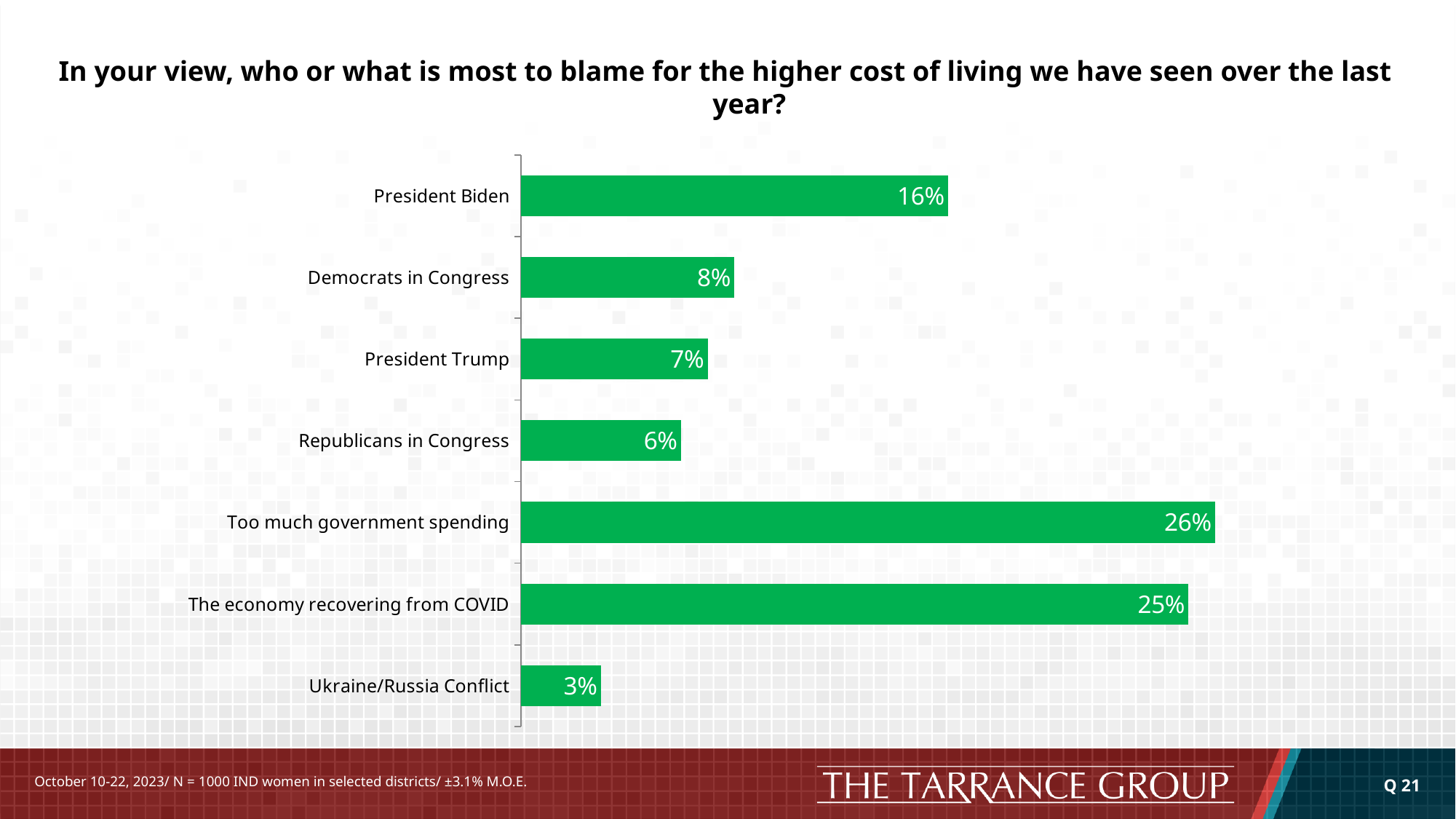
What is the difference between Democrats in Congress and Republicans in Congress? 2% What value is shown for The economy recovering from COVID? 25% Which is larger, the value for Democrats in Congress or the value for President Trump? Democrats in Congress What percentage is shown for the Ukraine/Russia Conflict? 3% What colour are the bars in the chart? Green What value is shown for Too much government spending? 26% Which category has the highest value? Too much government spending What kind of chart is shown on the slide? Bar chart What percentage of respondents blame President Biden for the higher cost of living? 16% What is the difference between the values for President Biden and President Trump? 9% Which category has the lowest value? Ukraine/Russia Conflict How many categories are shown in the chart? 7